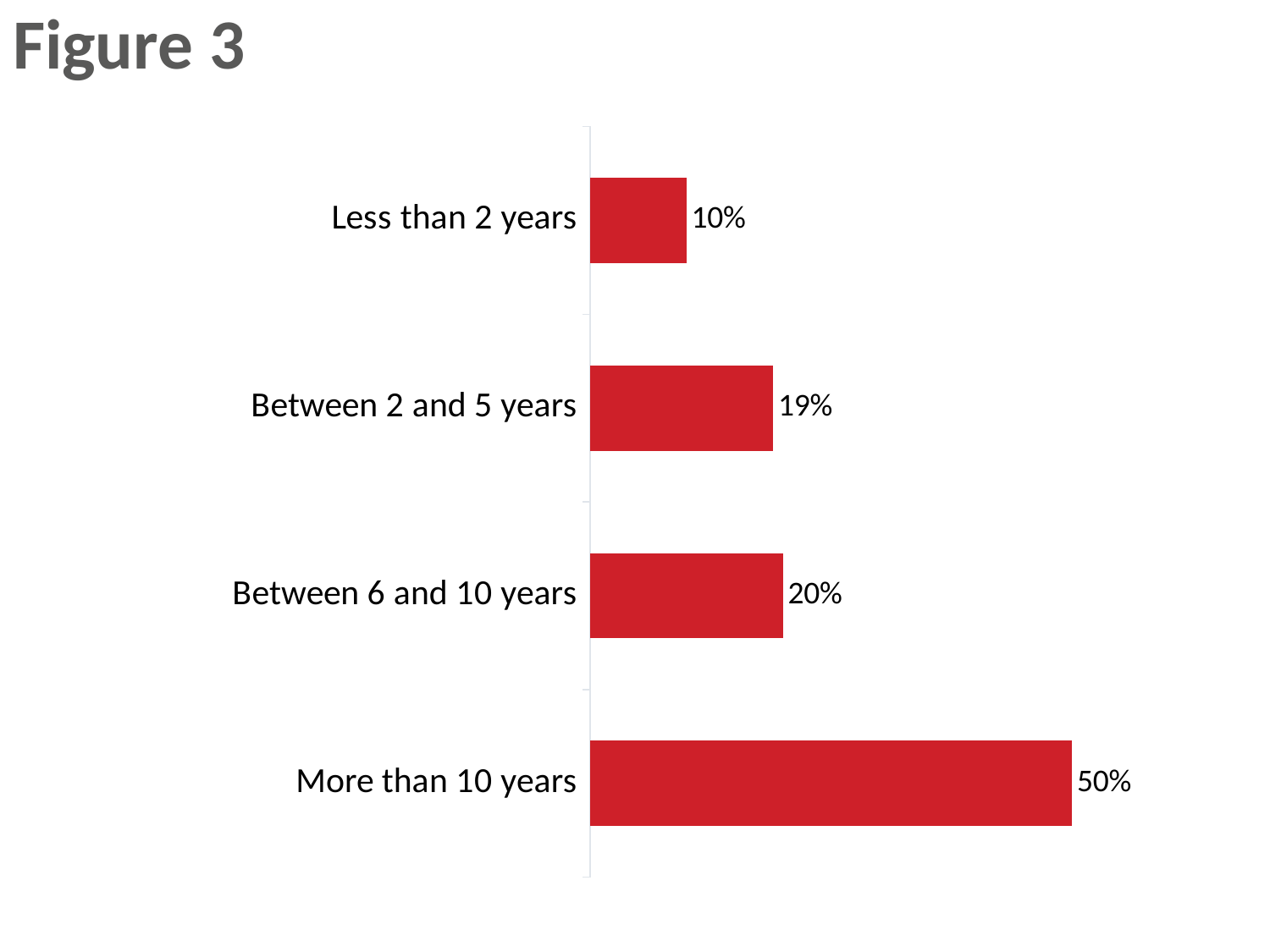
What is the difference between the values for 'Between 6 and 10 years' and 'Between 2 and 5 years'? 1% What is the value for 'Between 2 and 5 years'? 19% What is the title shown above the chart? Figure 3 How many categories are shown in the chart? 4 What is the value for 'Between 6 and 10 years'? 20% What is the value for 'More than 10 years'? 50% What is the value for 'Less than 2 years'? 10% What kind of chart is shown on the slide? Bar chart Which category has the lowest value? Less than 2 years Which is larger: the value for 'Between 2 and 5 years' or the value for 'Less than 2 years'? Between 2 and 5 years What is the difference between the values for 'More than 10 years' and 'Less than 2 years'? 40% Which category has the highest value? More than 10 years